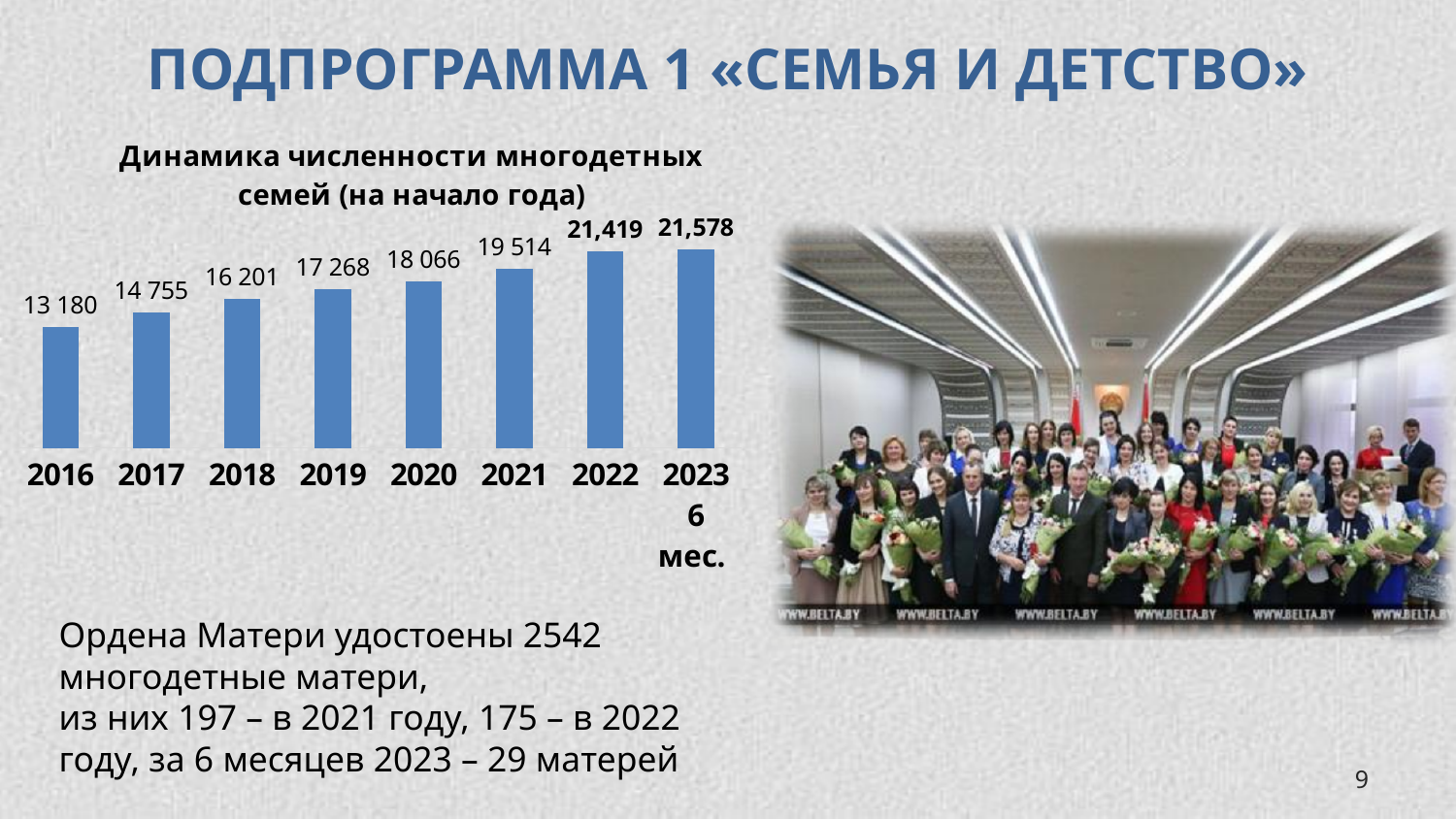
Which category has the highest value? 2023 (6 мес.) What is the title of the chart? Динамика численности многодетных семей (на начало года) What is the value for 2023 (6 мес.)? 21,578 How many categories (bars) are shown in the chart? 8 What is the value for 2016? 13 180 What is the value for 2022? 21,419 Which is larger, the value for 2018 or the value for 2021? 2021 What is the difference between the values for 2020 and 2019? 798 What is the difference between the values for 2023 (6 мес.) and 2022? 159 What is the value for 2019? 17 268 What type of chart is shown on the slide? bar chart Which year has the lowest value? 2016